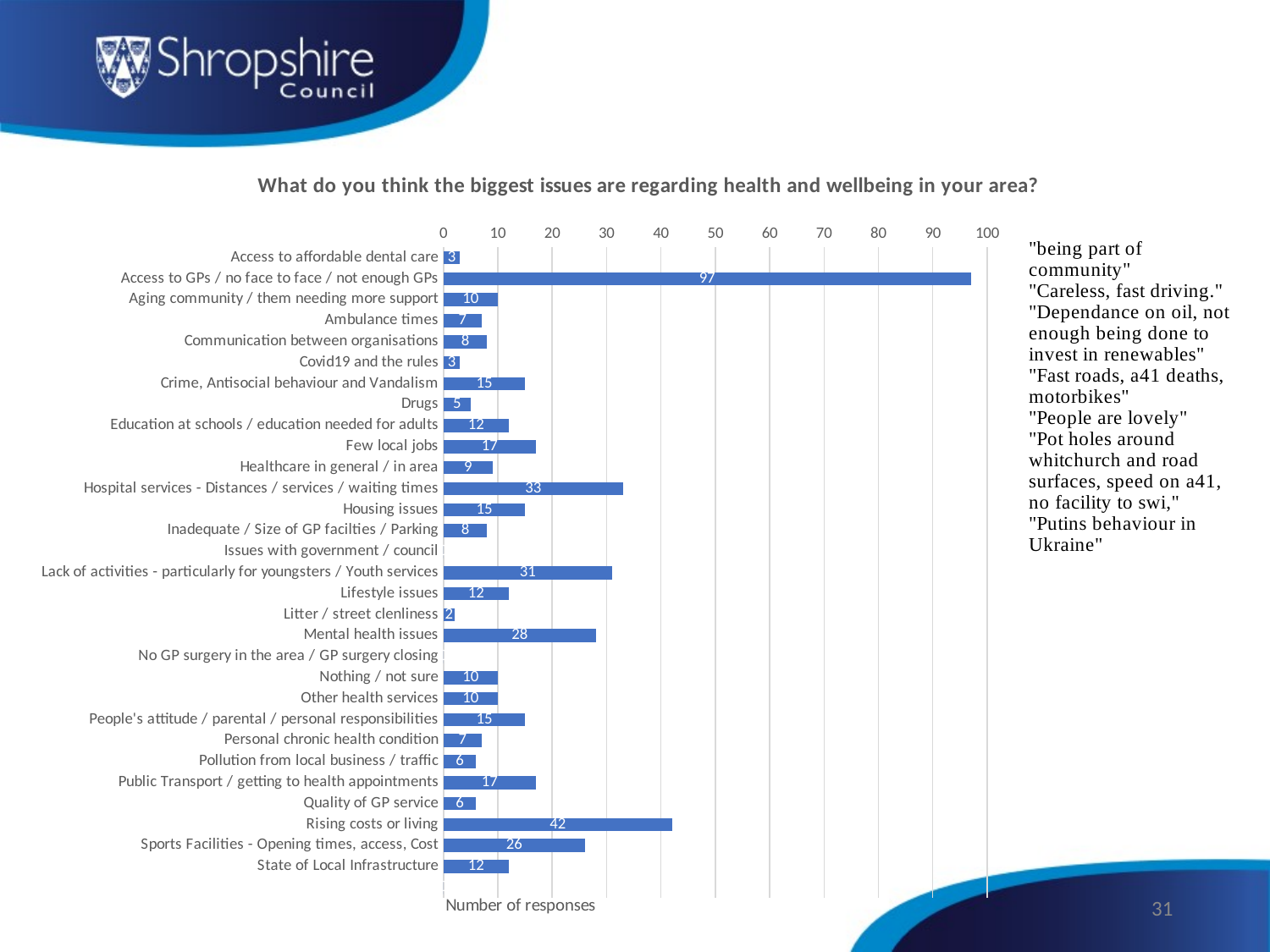
Which category has the highest number of responses? Access to GPs / no face to face / not enough GPs What is the number of responses for 'Hospital services - Distances / services / waiting times'? 33 What is the number of responses for 'Mental health issues'? 28 What is the difference in responses between 'Hospital services - Distances / services / waiting times' and 'Lack of activities - particularly for youngsters / Youth services'? 2 What is the number of responses for 'Rising costs or living'? 42 How many categories are listed on the chart? 30 Which has more responses, 'Few local jobs' or 'Drugs'? Few local jobs What is the number of responses for 'Sports Facilities - Opening times, access, Cost'? 26 What is the label on the horizontal axis of the chart? Number of responses Is the value for 'Access to GPs / no face to face / not enough GPs' greater or less than 90? greater What is the difference in responses between 'Access to GPs / no face to face / not enough GPs' and 'Rising costs or living'? 55 What type of chart is shown on the slide? bar chart